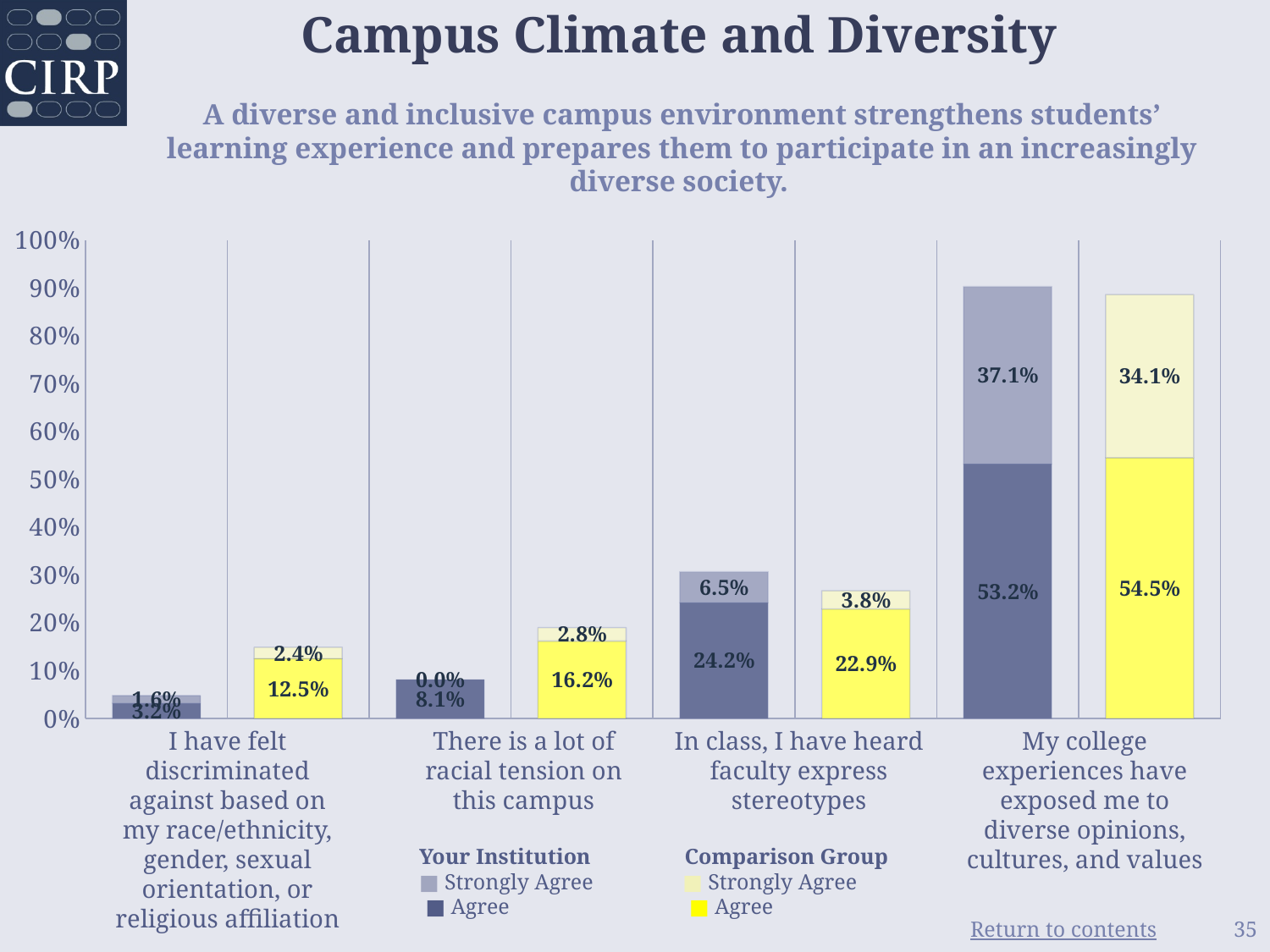
What is the total (Agree plus Strongly Agree) for the Comparison Group on 'In class, I have heard faculty express stereotypes'? 26.7% Which statement has the highest combined agreement for Your Institution? My college experiences have exposed me to diverse opinions, cultures, and values What kind of chart is shown on the slide? Stacked bar chart What is the total (Agree plus Strongly Agree) for Your Institution on 'My college experiences have exposed me to diverse opinions, cultures, and values'? 90.3% What is the Comparison Group 'Agree' value for 'I have felt discriminated against based on my race/ethnicity, gender, sexual orientation, or religious affiliation'? 12.5% What is the Your Institution 'Strongly Agree' value for 'In class, I have heard faculty express stereotypes'? 6.5% What percentage of the Comparison Group strongly agree that 'There is a lot of racial tension on this campus'? 2.8% How many series does the legend list? 4 How much higher is the Comparison Group 'Agree' value than the Your Institution 'Agree' value for 'There is a lot of racial tension on this campus'? 8.1 percentage points For 'In class, I have heard faculty express stereotypes', which group has the larger 'Strongly Agree' value, Your Institution or the Comparison Group? Your Institution Which statement has the lowest combined agreement for Your Institution? I have felt discriminated against based on my race/ethnicity, gender, sexual orientation, or religious affiliation What percentage of students at Your Institution agree that 'My college experiences have exposed me to diverse opinions, cultures, and values'? 53.2%